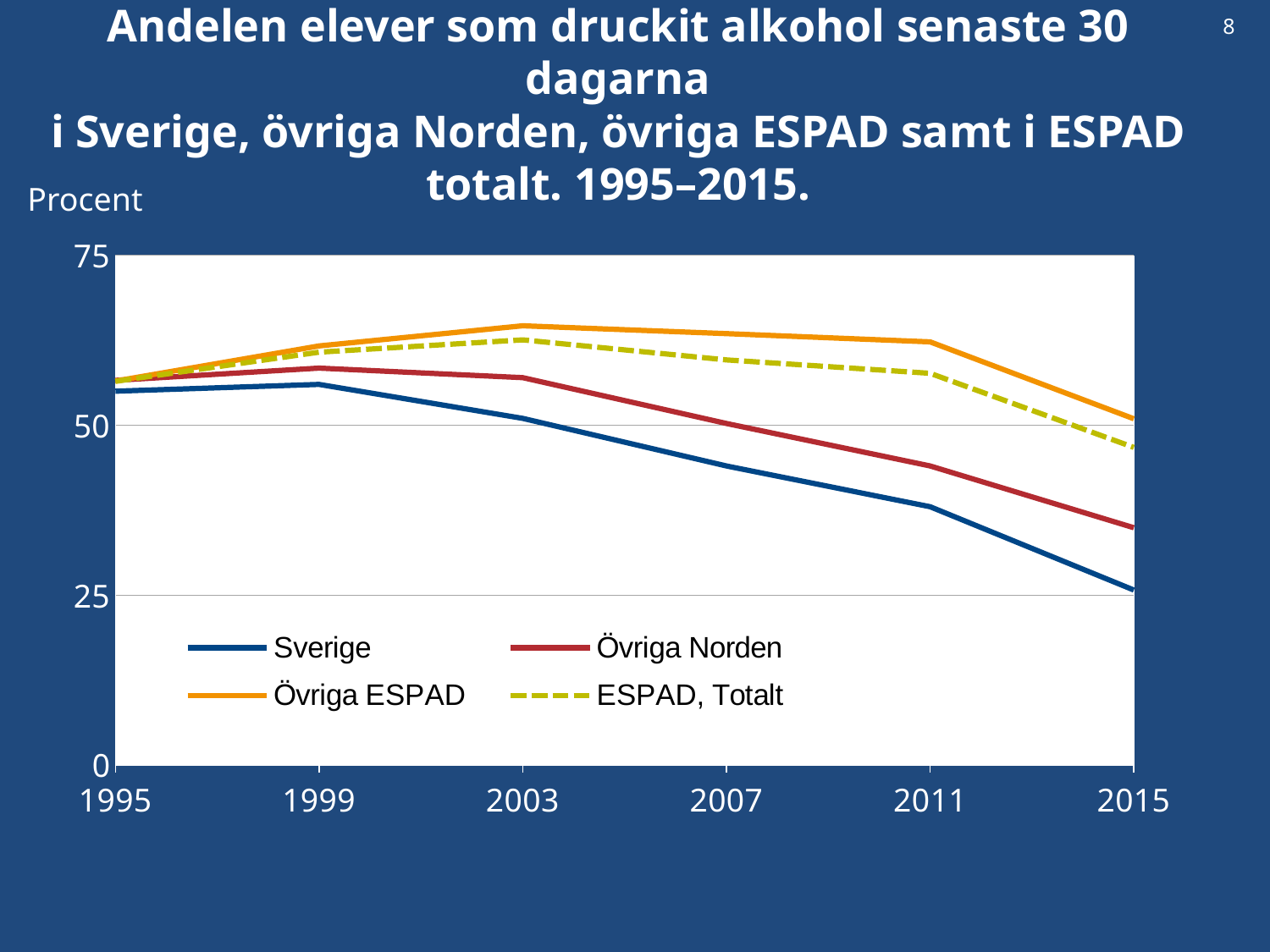
Is the value for Sverige in 2011 greater or less than 50? less What kind of chart is shown on the slide? line chart Which series is drawn with a dashed line? ESPAD, Totalt How many series does the legend list? 4 Which series has the highest value in 2015? Övriga ESPAD Is the value for Övriga Norden in 2015 greater or less than 50? less In 2007, which is larger: the value for Sverige or the value for Övriga Norden? Övriga Norden Which series has the lowest value in 2007? Sverige Which series has the lowest value in 2015? Sverige How many years are marked along the x axis? 6 Is the value for Övriga ESPAD in 2003 greater or less than 50? greater Does the value for Sverige rise or fall from 1999 to 2015? fall